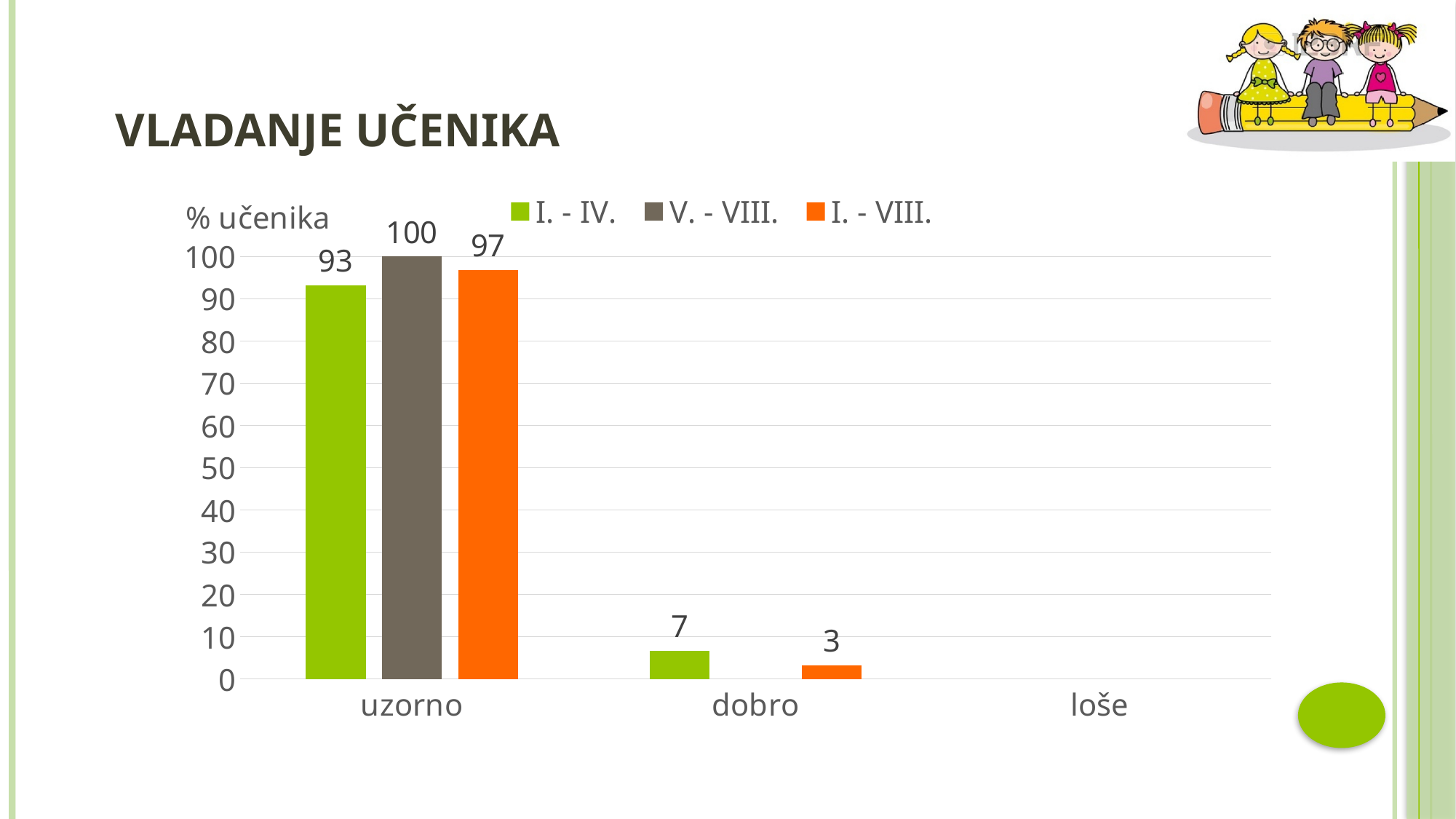
What is the value for I. - IV. in the dobro category? 7 Which is larger in the dobro category: I. - IV. or I. - VIII.? I. - IV. What is the value for I. - VIII. in the dobro category? 3 What is the value for I. - VIII. in the uzorno category? 97 What is the difference between the V. - VIII. and I. - IV. values in the uzorno category? 7 Which series has the highest value in the uzorno category? V. - VIII. What is the value for V. - VIII. in the uzorno category? 100 What is the value for I. - IV. in the uzorno category? 93 What is the label on the vertical axis of the chart? % učenika How many categories are shown on the x axis? 3 How many series does the legend list? 3 What kind of chart is shown on the slide? bar chart